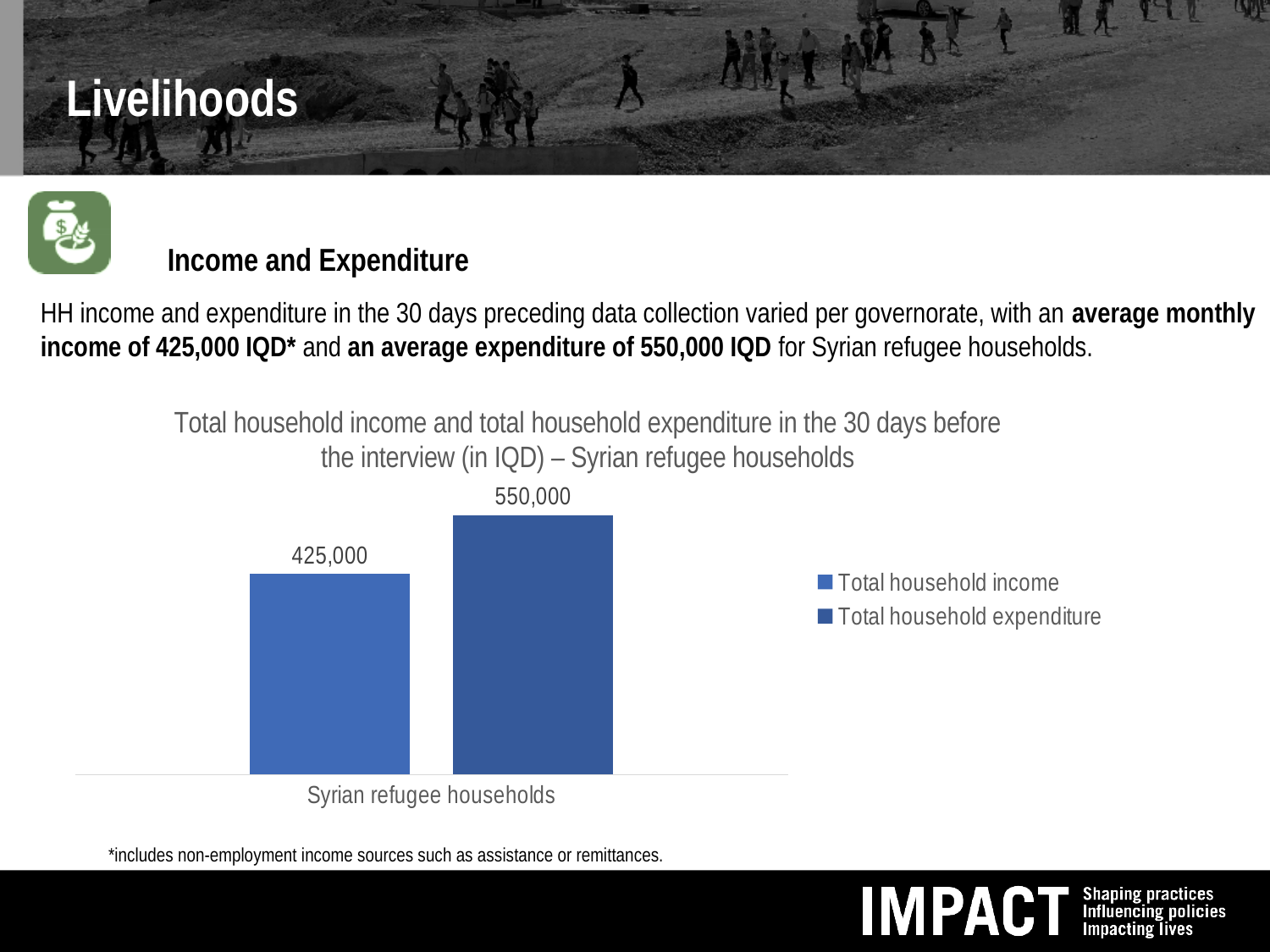
What is the category label on the x axis? Syrian refugee households How many series does the legend list? 2 Which series has the highest value? Total household expenditure What is the value for Total household income? 425,000 What is the value for Total household expenditure? 550,000 How many categories are shown on the x axis? 1 What kind of chart is shown? Bar chart Which series has the higher value, Total household income or Total household expenditure? Total household expenditure What is the difference between Total household expenditure and Total household income? 125,000 What is the title of the chart? Total household income and total household expenditure in the 30 days before the interview (in IQD) – Syrian refugee households Which series has the lowest value? Total household income